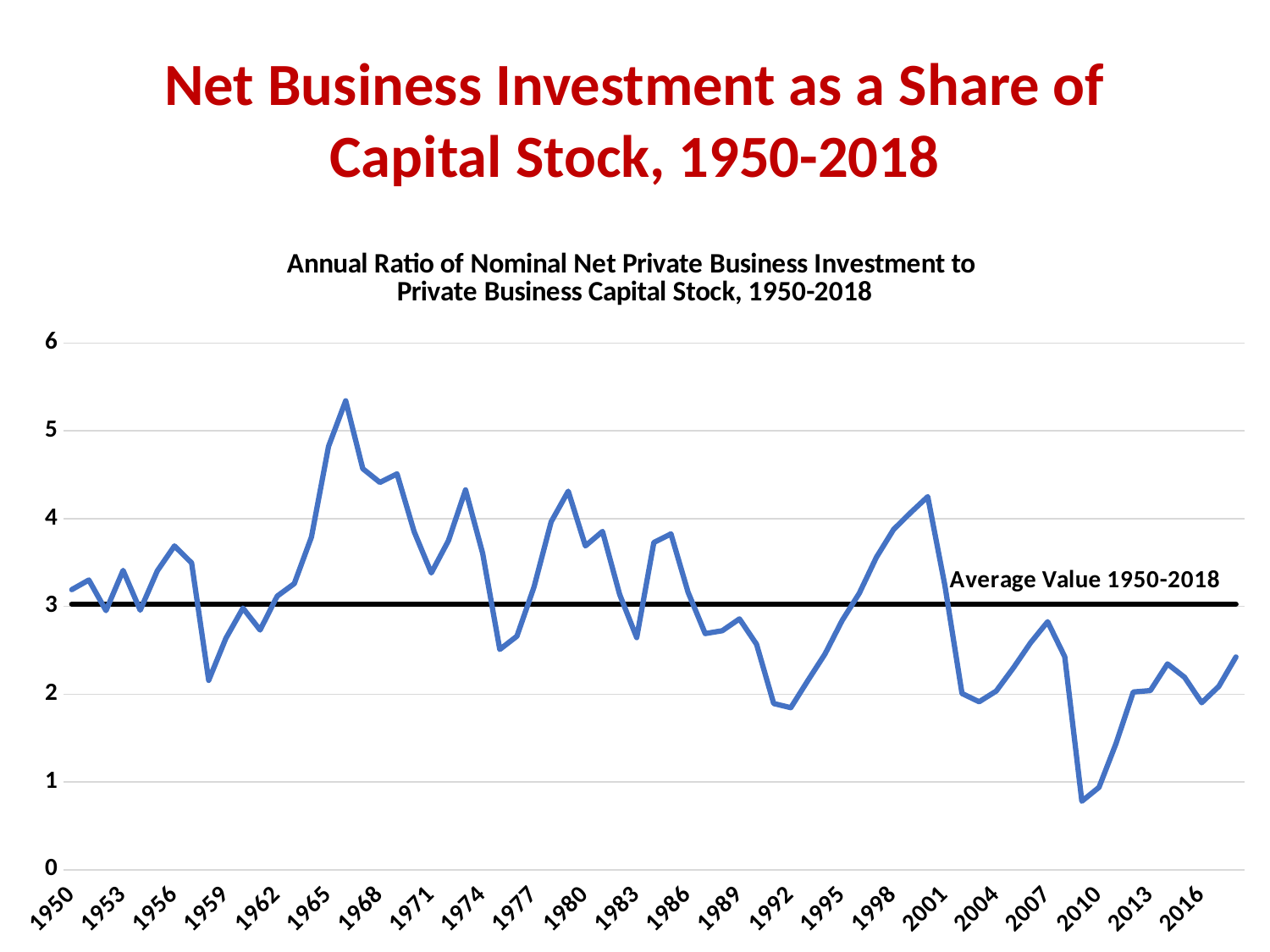
What is the label on the horizontal black line in the chart? Average Value 1950-2018 Is the value for 1998 greater or less than 3? greater At what value on the vertical axis does the Average Value 1950-2018 line sit? 3 What kind of chart is shown on the slide? line chart Is the value for 1959 greater or less than 3? less Which year has the larger value, 1968 or 1992? 1968 Does the line rise or fall between 2007 and 2010? fall Does the line rise or fall between 1965 and 1968? fall What is the title printed above the chart's plot area? Annual Ratio of Nominal Net Private Business Investment to Private Business Capital Stock, 1950-2018 Is the value for 1992 greater or less than 2? less